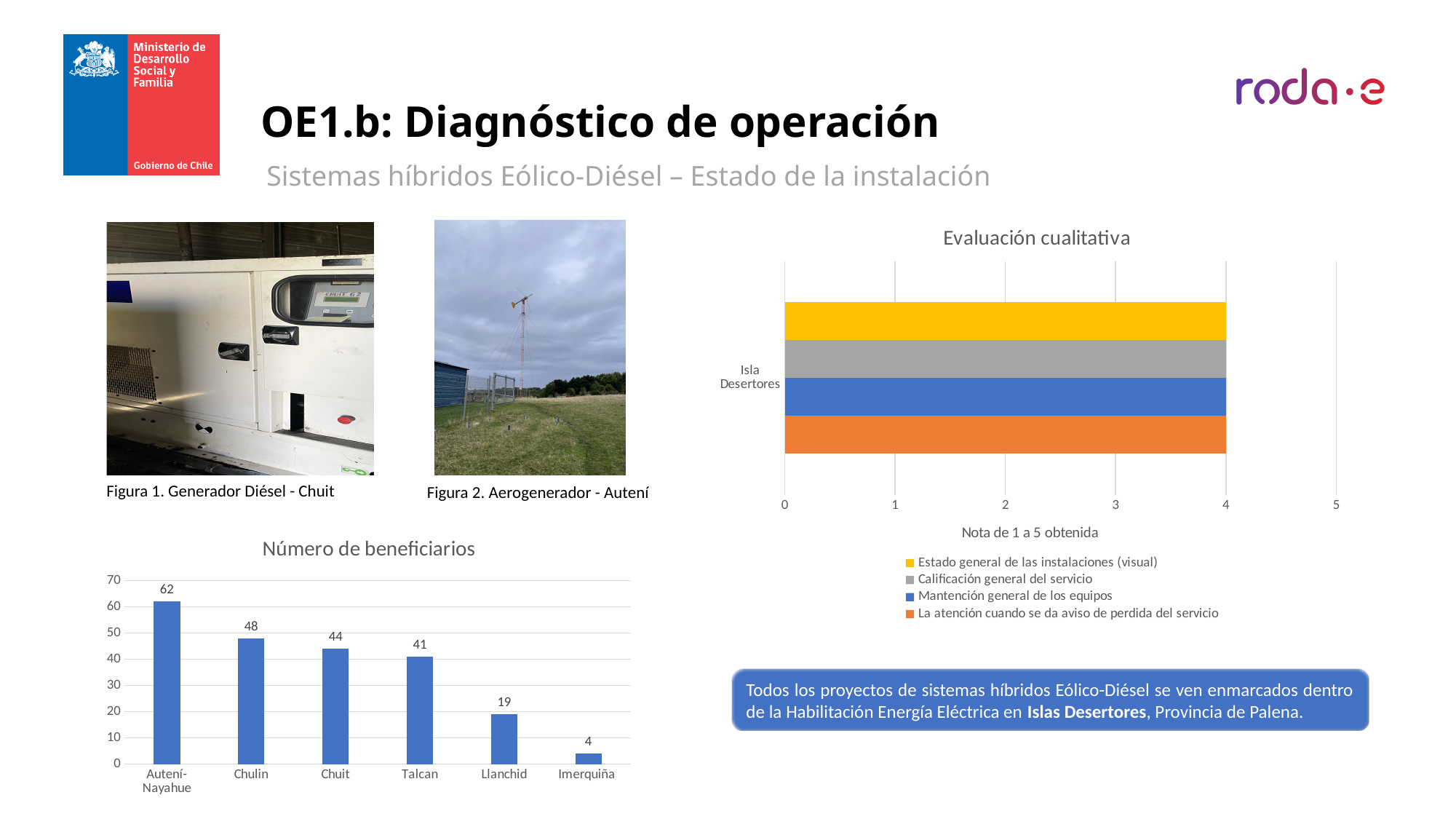
What kind of chart is 'Número de beneficiarios'? Bar chart How many series does the legend of the 'Evaluación cualitativa' chart list? 4 In the 'Número de beneficiarios' chart, what is the value for Llanchid? 19 In the 'Número de beneficiarios' chart, how many beneficiaries are shown for Chuit? 44 In the 'Número de beneficiarios' chart, what is the difference between the values for Chulin and Talcan? 7 What is the x-axis title of the 'Evaluación cualitativa' chart? Nota de 1 a 5 obtenida In the 'Número de beneficiarios' chart, which category has the lowest number of beneficiaries? Imerquiña How many categories are shown in the 'Número de beneficiarios' chart? 6 In the 'Número de beneficiarios' chart, which category has the highest number of beneficiaries? Autení-Nayahue In the 'Evaluación cualitativa' chart, what score does Isla Desertores get for 'Calificación general del servicio'? 4 In the 'Número de beneficiarios' chart, which has more beneficiaries, Chuit or Llanchid? Chuit In the 'Evaluación cualitativa' chart, is the value for 'Mantención general de los equipos' greater or less than 3? greater